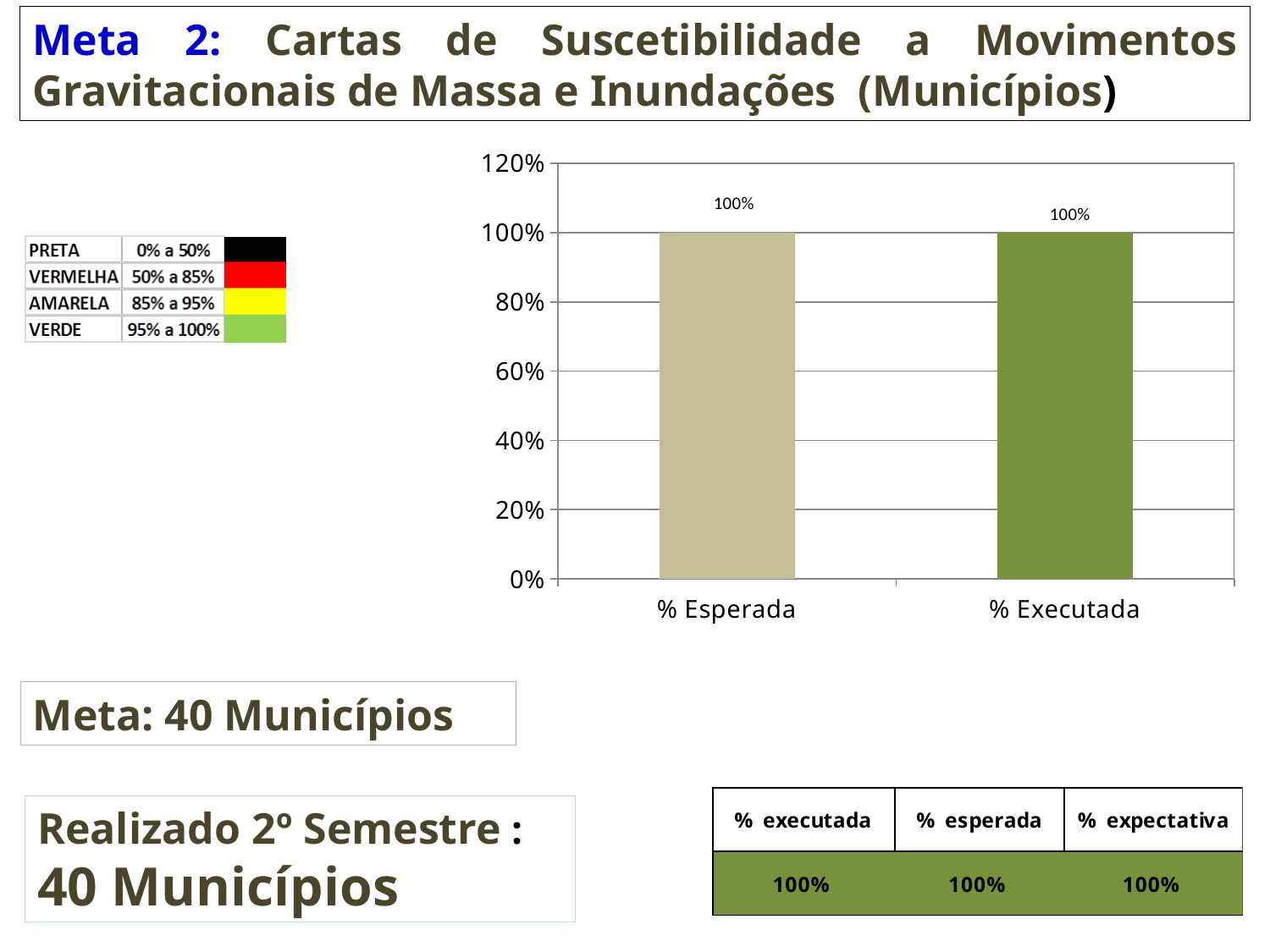
What is the value of the % Executada bar? 100% What kind of chart is shown on the slide? bar chart Are the values of the two bars equal? yes What is the value of the % Esperada bar? 100% Is the value for % Executada greater or less than 80%? greater What is the difference between the % Esperada and % Executada bars? 0% What is the highest value shown on the vertical axis? 120% What is the label of the bar on the right side of the chart? % Executada How many bars are plotted in the chart? 2 Is the value for % Esperada greater or less than 120%? less